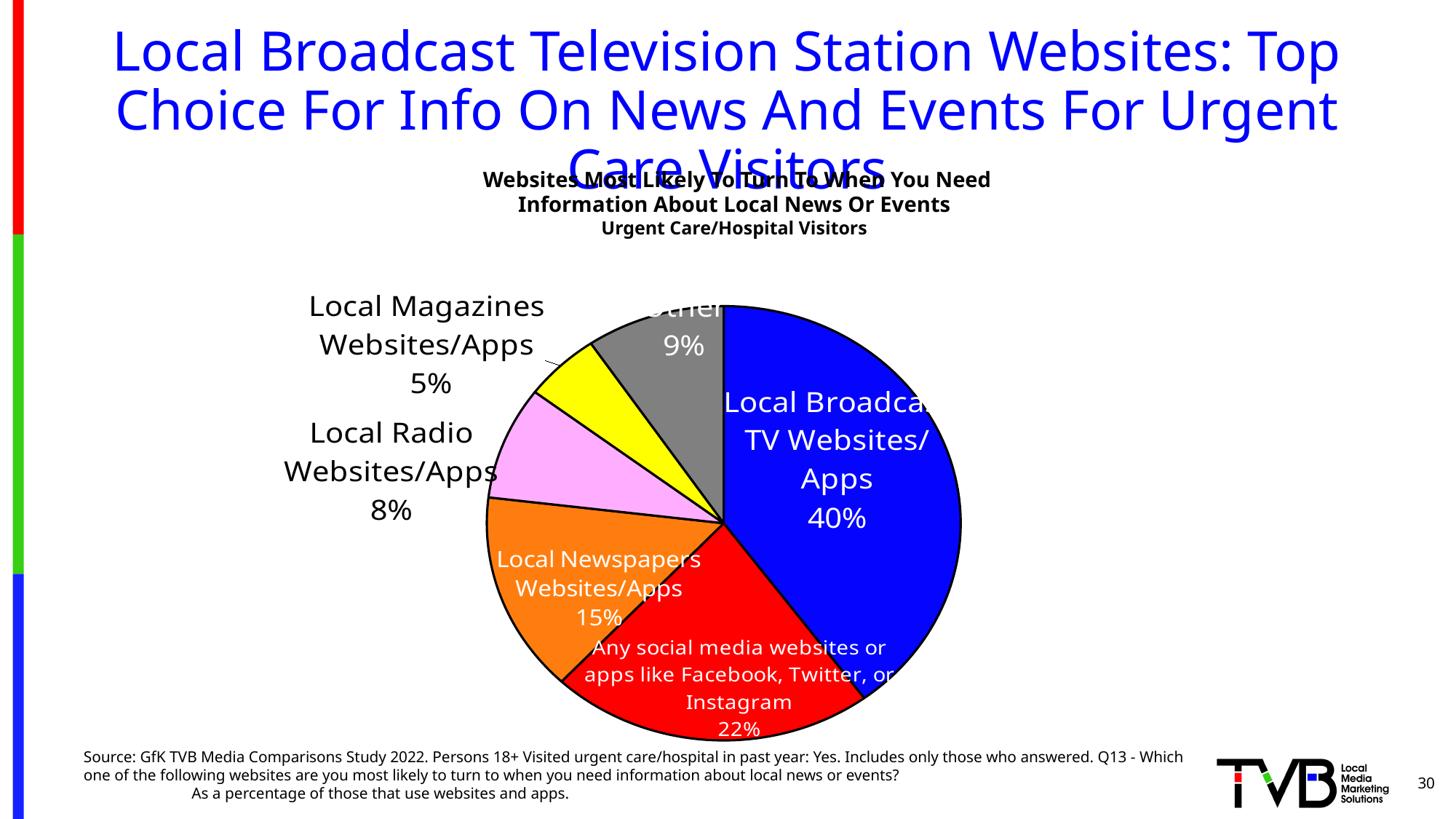
How many slices does the pie chart have? 6 What is the difference in percentage points between Local Broadcast TV Websites/Apps and any social media websites or apps? 18 What is the value shown for Local Radio Websites/Apps? 8% What is the value shown for Local Newspapers Websites/Apps? 15% Which website category has the smallest slice of the pie? Local Magazines Websites/Apps What kind of chart is shown on the slide? pie chart Which website category has the largest slice of the pie? Local Broadcast TV Websites/Apps Which is larger: the slice for Local Newspapers Websites/Apps or the slice for Local Radio Websites/Apps? Local Newspapers Websites/Apps What percentage of urgent care/hospital visitors are most likely to turn to Local Broadcast TV Websites/Apps for local news or events? 40% What share of the pie is taken by any social media websites or apps like Facebook, Twitter, or Instagram? 22% What colour is the slice for Local Broadcast TV Websites/Apps? blue What is the value shown for Local Magazines Websites/Apps? 5%